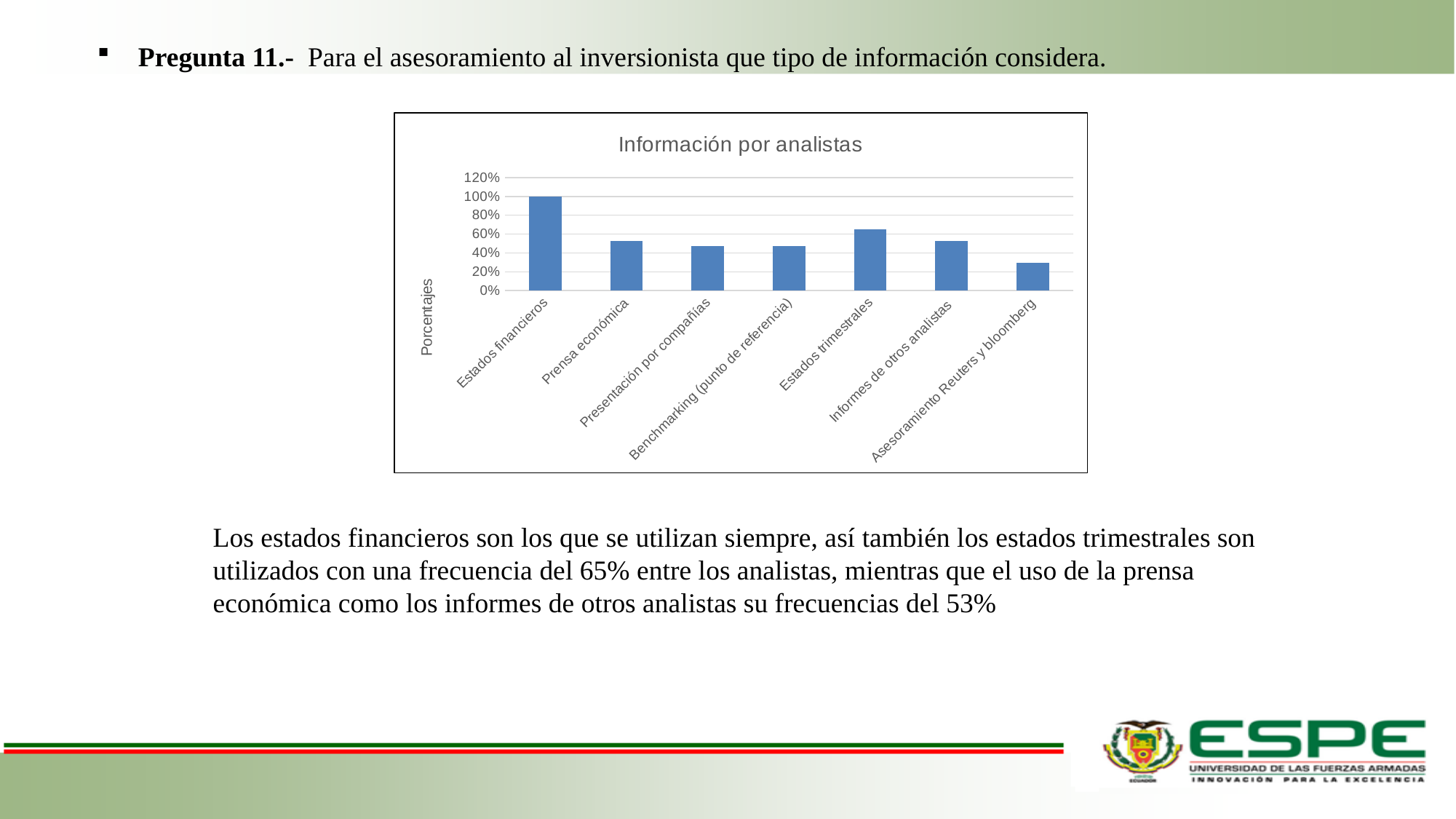
What is the title of the chart? Información por analistas How many categories are shown in the chart? 7 Which category has the lowest value? Asesoramiento Reuters y bloomberg What type of chart is shown on the slide? Bar chart What is the value for Estados financieros? 100% Is the value for Estados trimestrales greater or less than 60%? greater Which category has the highest value? Estados financieros Is the value for Asesoramiento Reuters y bloomberg greater or less than 40%? less What is the label of the vertical axis? Porcentajes Which is larger, the value for Estados trimestrales or the value for Prensa económica? Estados trimestrales Is the value for Prensa económica greater or less than 40%? greater